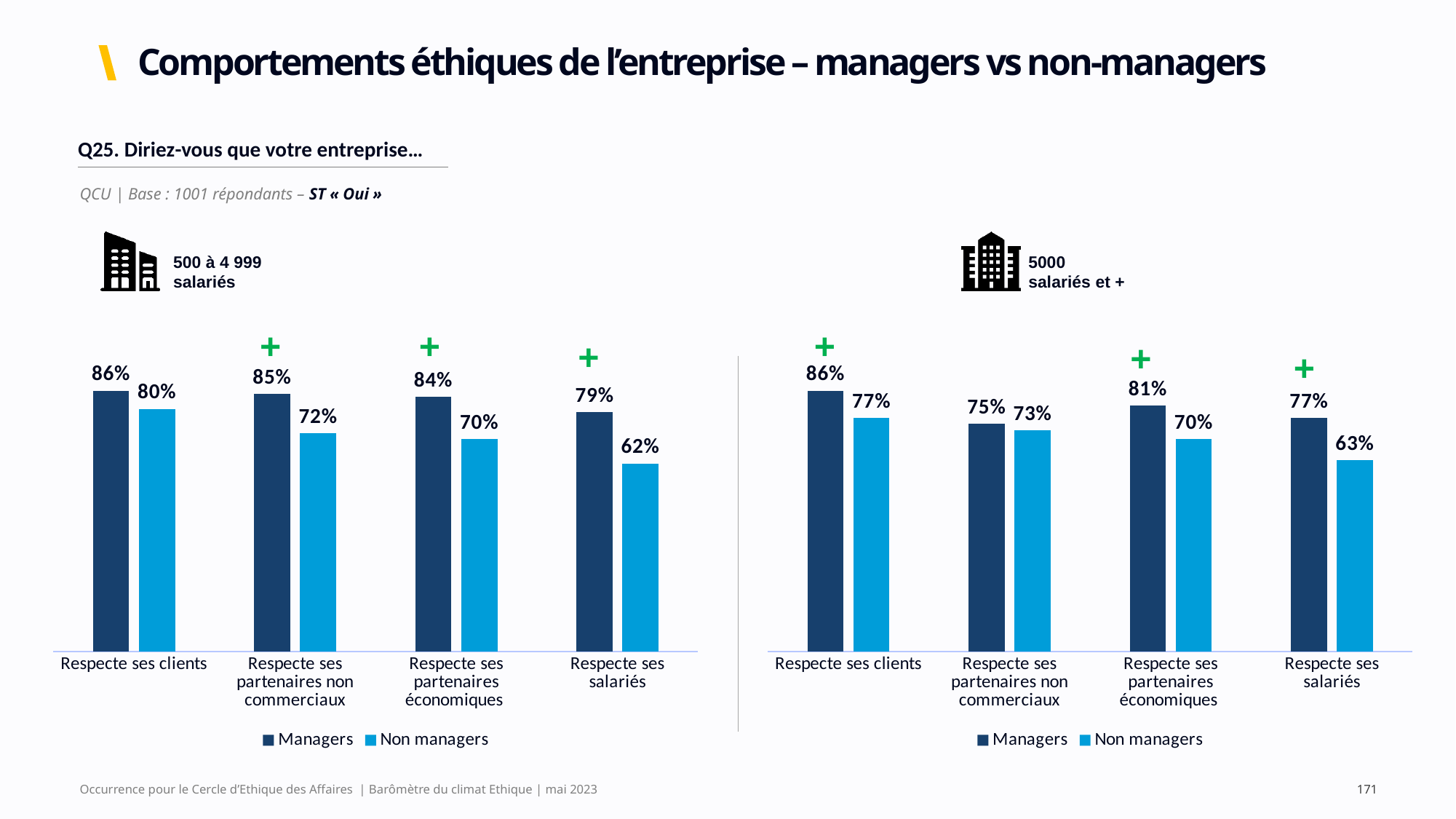
In the left chart (500 à 4 999 salariés), what is the difference between Managers and Non managers for "Respecte ses salariés"? 17 percentage points In the left chart (500 à 4 999 salariés), which category has the lowest Non managers value? Respecte ses salariés In the right chart (5000 salariés et +), what is the value for Non managers for "Respecte ses partenaires non commerciaux"? 73% In the right chart (5000 salariés et +), what is the value for Managers for "Respecte ses partenaires économiques"? 81% How many series does the legend of the left chart (500 à 4 999 salariés) list? 2 How many categories are shown on the x axis of the right chart (5000 salariés et +)? 4 In the left chart (500 à 4 999 salariés), which is larger: the Non managers value for "Respecte ses clients" or for "Respecte ses partenaires non commerciaux"? Respecte ses clients In the left chart (500 à 4 999 salariés), what is the value for Non managers for "Respecte ses salariés"? 62% In the left chart (500 à 4 999 salariés), what is the value for Managers for "Respecte ses clients"? 86% In the right chart (5000 salariés et +), what is the difference between Managers and Non managers for "Respecte ses clients"? 9 percentage points In the right chart (5000 salariés et +), which category has the highest Managers value? Respecte ses clients What type of chart is the left chart (500 à 4 999 salariés)? Bar chart